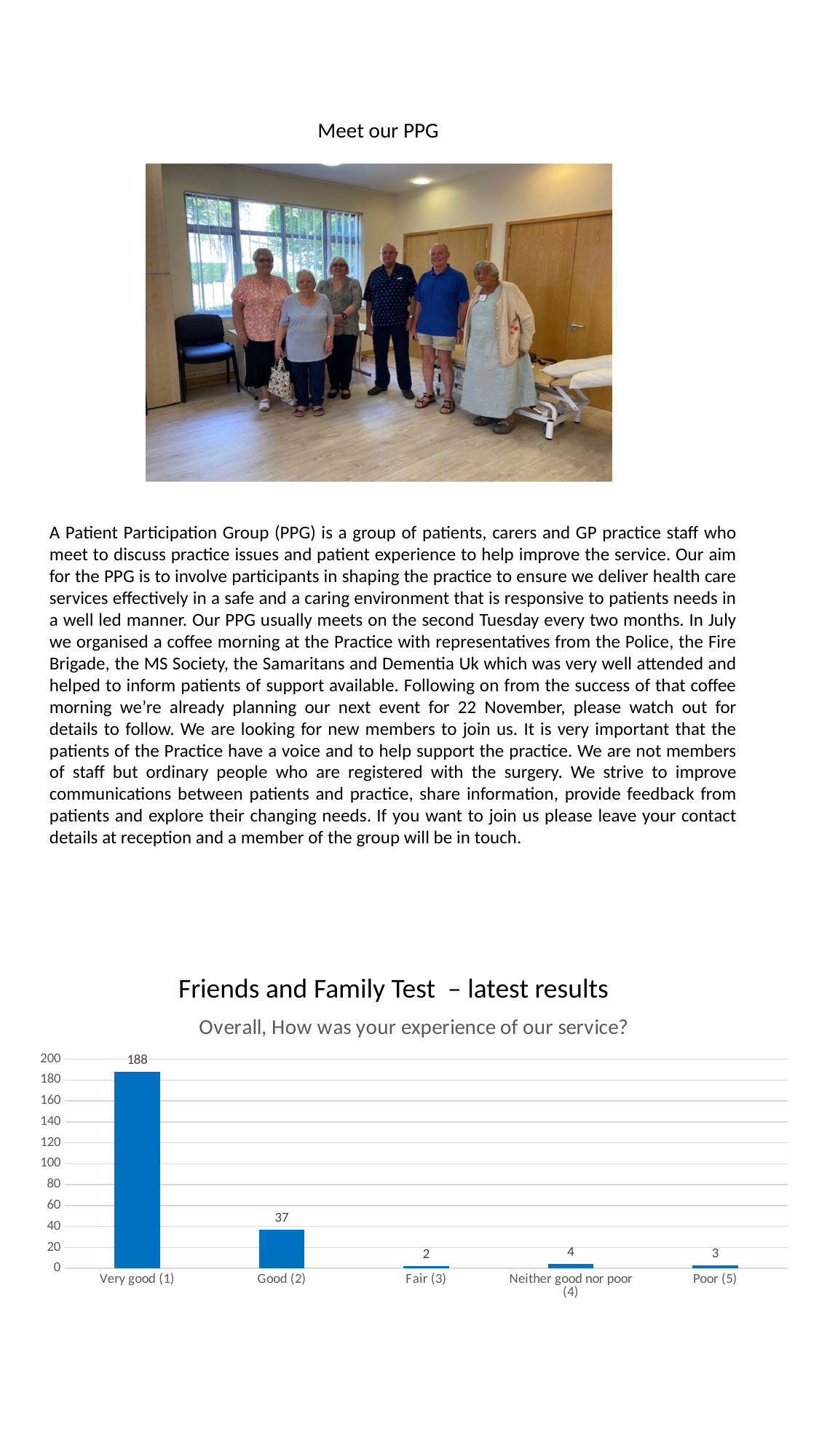
What is the value for Neither good nor poor (4)? 4 How many categories are shown on the x axis? 5 What is the difference between the values for Very good (1) and Good (2)? 151 What is the value for Poor (5)? 3 Is the value for Good (2) greater or less than 100? less What is the value for Good (2)? 37 Which category has the lowest value? Fair (3) Which is larger, the value for Neither good nor poor (4) or the value for Poor (5)? Neither good nor poor (4) Which category has the highest value? Very good (1) What is the value for Fair (3)? 2 What is the value for Very good (1)? 188 What kind of chart is shown? bar chart